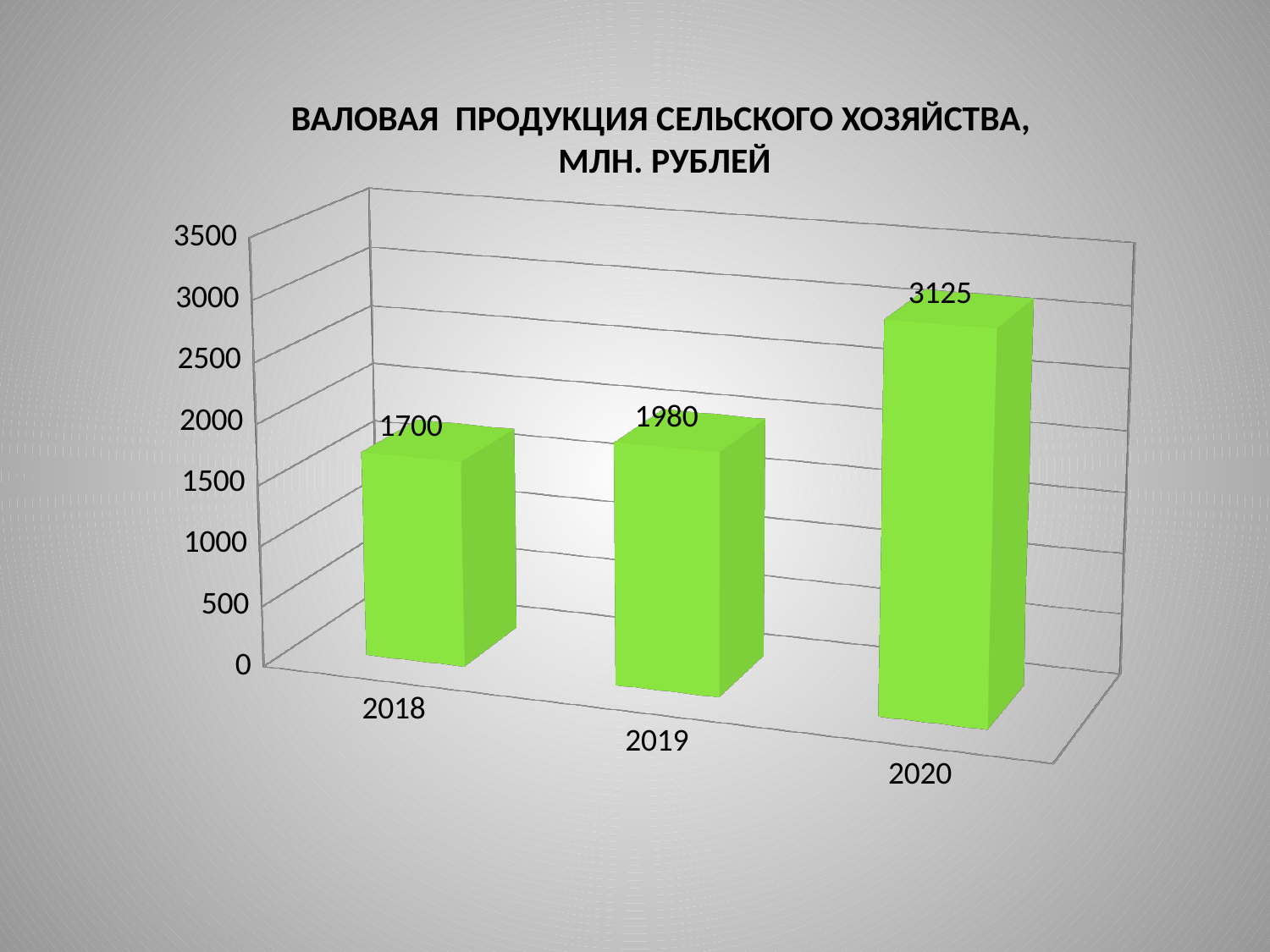
What is the difference between the values for 2020 and 2019? 1145 How many years are shown on the chart? 3 What is the value for 2020? 3125 Is the value for 2020 greater or less than 3000? greater What is the difference between the values for 2019 and 2018? 280 What kind of chart is shown on the slide? bar chart What is the value for 2018? 1700 Which year has the lowest value? 2018 Do the values rise or fall from 2018 to 2020? rise What is the value for 2019? 1980 Which year has the highest value? 2020 Which is larger, the value for 2018 or the value for 2019? 2019